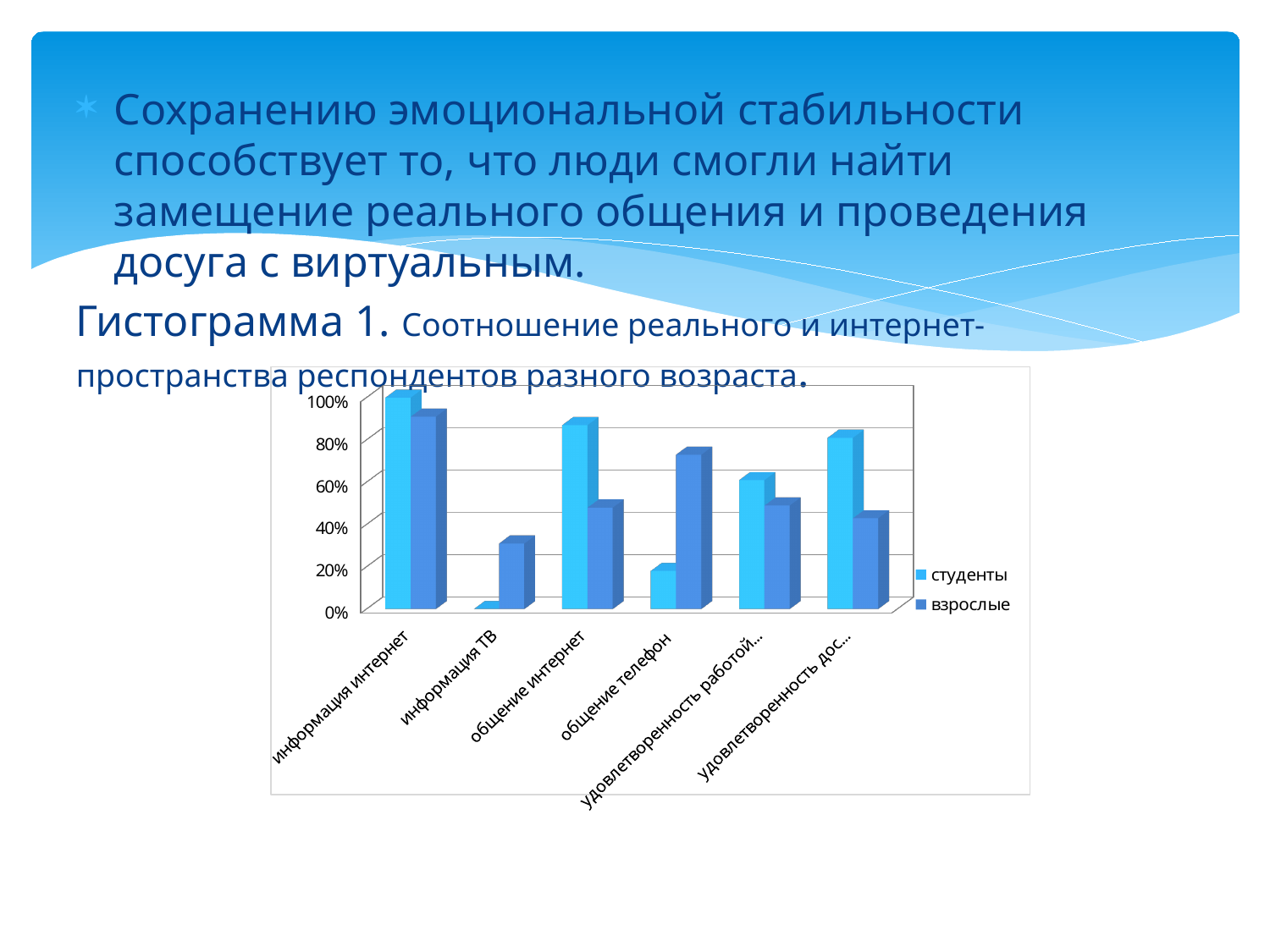
Is the value for взрослые in the category общение телефон greater or less than 60%? greater Which category has the highest value for the взрослые series? информация интернет Is the value for студенты in the category общение телефон greater or less than 20%? less What are the two entries listed in the chart legend? студенты and взрослые What kind of chart is shown on the slide? bar chart Which category has the lowest value for the студенты series? информация ТВ How many series does the chart legend list? 2 How many categories are shown on the x axis of the chart? 6 For the category общение телефон, which series has the larger value, студенты or взрослые? взрослые Which category has the highest value for the студенты series? информация интернет For the category общение интернет, which series has the larger value, студенты or взрослые? студенты Is the value for взрослые in the category информация ТВ greater or less than 40%? less